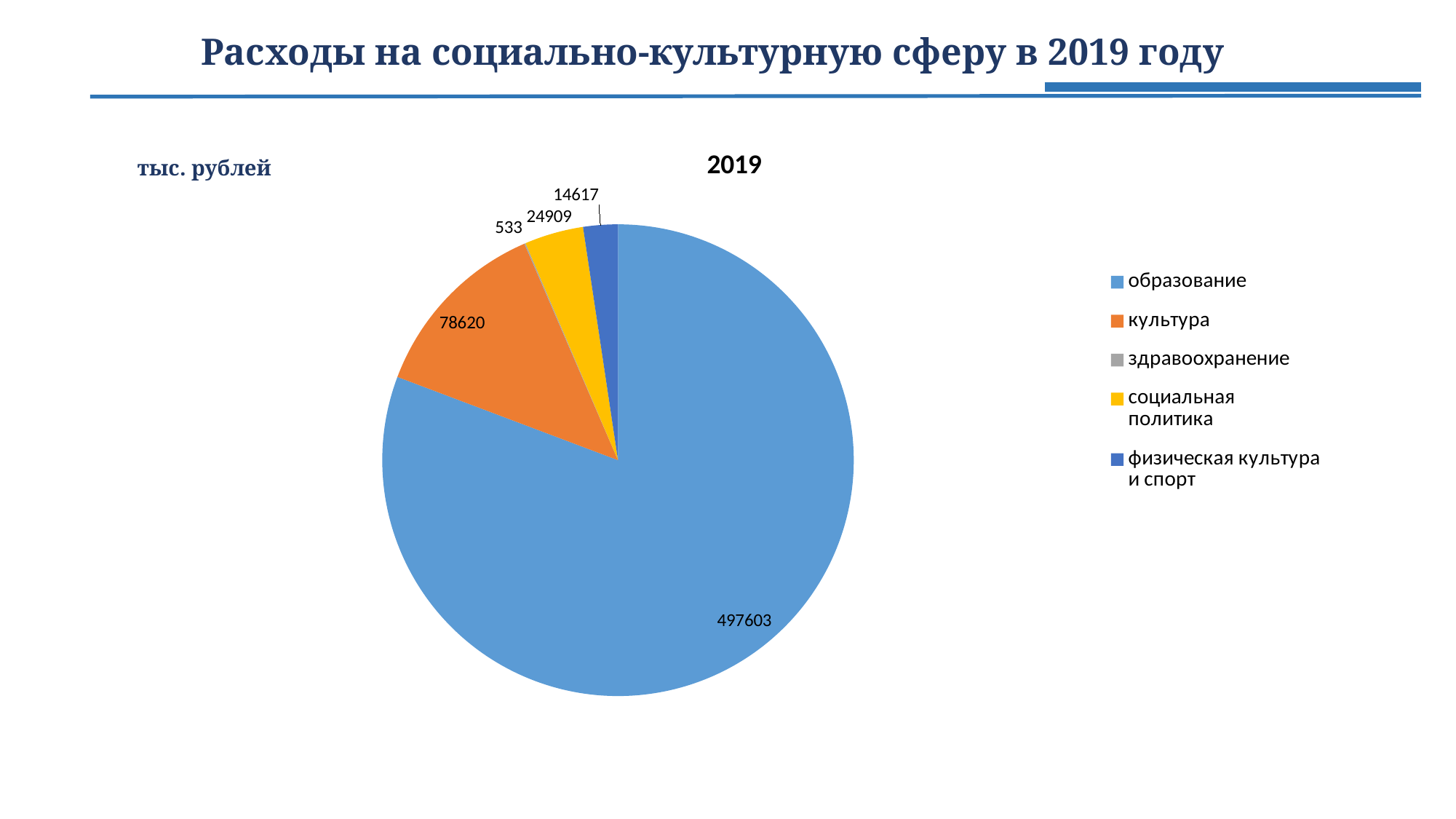
What is the difference between the values for социальная политика and физическая культура и спорт? 10292 How many categories does the pie chart show? 5 What is the value for образование in the pie chart? 497603 Which category has the smallest slice in the pie chart? здравоохранение Which is larger, the value for культура or the value for социальная политика? культура What is the difference between the values for образование and культура? 418983 What is the value for культура in the pie chart? 78620 What type of chart is shown on the slide? pie chart Which category has the largest slice in the pie chart? образование What is the value for здравоохранение in the pie chart? 533 What is the value for социальная политика in the pie chart? 24909 What is the value for физическая культура и спорт in the pie chart? 14617